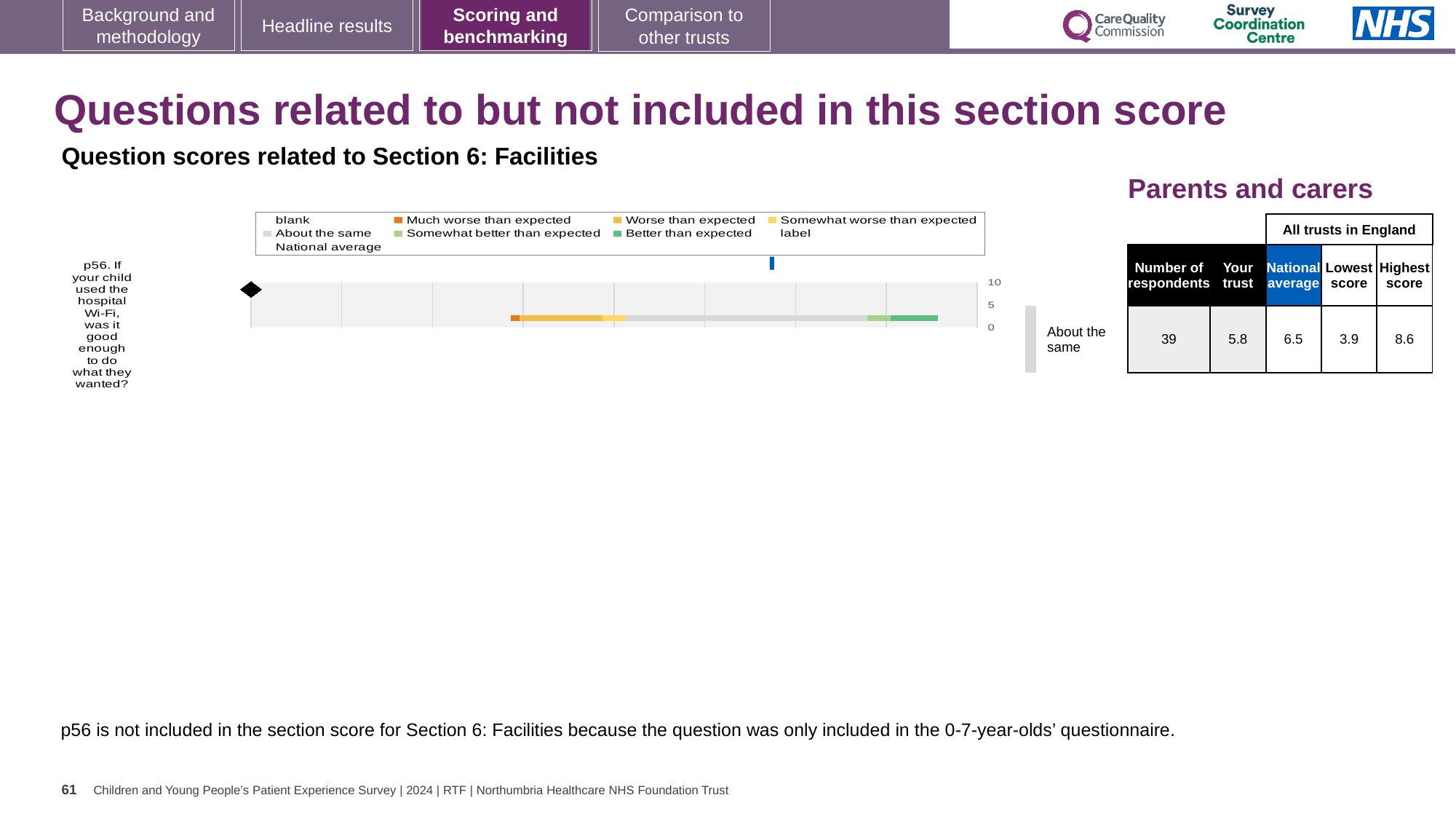
What is the 'Your trust' score for question p56? 5.8 How many questions are plotted in the chart? 1 What is the national average score for question p56? 6.5 What is the lowest score among all trusts in England for question p56? 3.9 Is the trust's score for question p56 greater or less than 5? greater Which is larger for question p56: the trust's score or the national average? National average What kind of chart is used to show the benchmark bands for question p56? Bar chart What is the highest score among all trusts in England for question p56? 8.6 Which benchmark category is the trust's result for question p56 placed in? About the same What is the difference between the highest and lowest scores for question p56? 4.7 How many respondents are shown for question p56? 39 By how much does the national average exceed the trust's score for question p56? 0.7